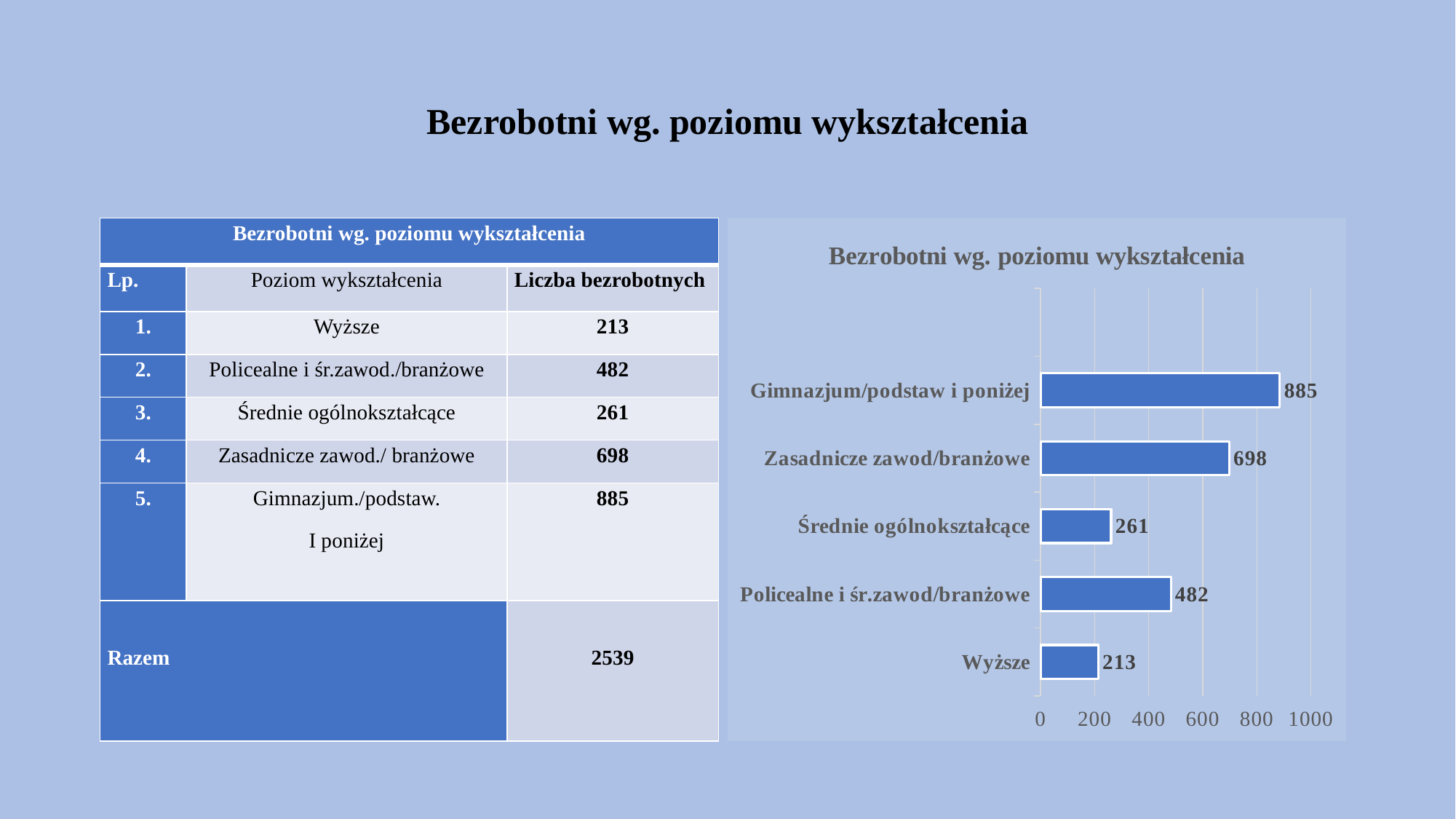
What is the highest value shown on the chart's horizontal axis? 1000 What is the value for Gimnazjum/podstaw i poniżej in the chart? 885 Which is larger, the value for Średnie ogólnokształcące or the value for Policealne i śr.zawod/branżowe? Policealne i śr.zawod/branżowe What is the title of the chart? Bezrobotni wg. poziomu wykształcenia Which category has the lowest value in the chart? Wyższe What is the value for Średnie ogólnokształcące in the chart? 261 Is the value for Zasadnicze zawod/branżowe greater or less than 600? greater What is the value for Wyższe in the chart? 213 Which category has the highest value in the chart? Gimnazjum/podstaw i poniżej What is the difference between the values for Zasadnicze zawod/branżowe and Policealne i śr.zawod/branżowe? 216 What kind of chart is shown on the slide? bar chart How many categories are shown in the chart? 5